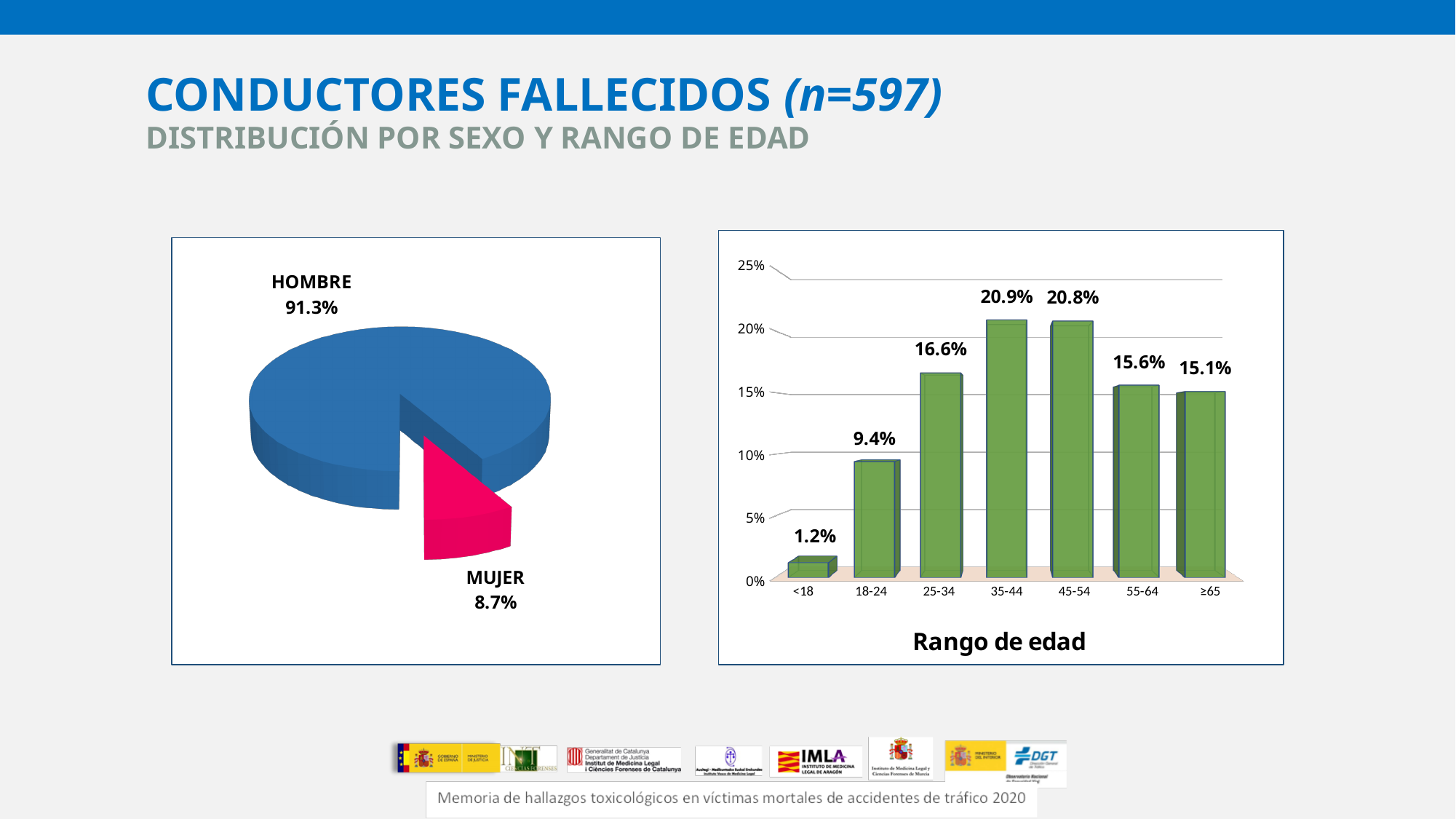
What is the x-axis title of the bar chart on the right? Rango de edad What kind of chart is the chart on the left of the slide? Pie chart In the bar chart on the right, what is the value for the 35-44 age range? 20.9% In the bar chart on the right, which age range has the lowest value? <18 In the bar chart on the right, what is the value for the <18 age range? 1.2% In the bar chart on the right, which age range has the highest value? 35-44 In the bar chart on the right, what is the difference between the values for 25-34 and 18-24? 7.2% How many age ranges are shown in the bar chart on the right? 7 In the pie chart on the left, what share is labelled for MUJER? 8.7% In the bar chart on the right, which is larger, the value for 55-64 or the value for ≥65? 55-64 What kind of chart is the chart on the right of the slide? Bar chart In the pie chart on the left, what share is labelled for HOMBRE? 91.3%